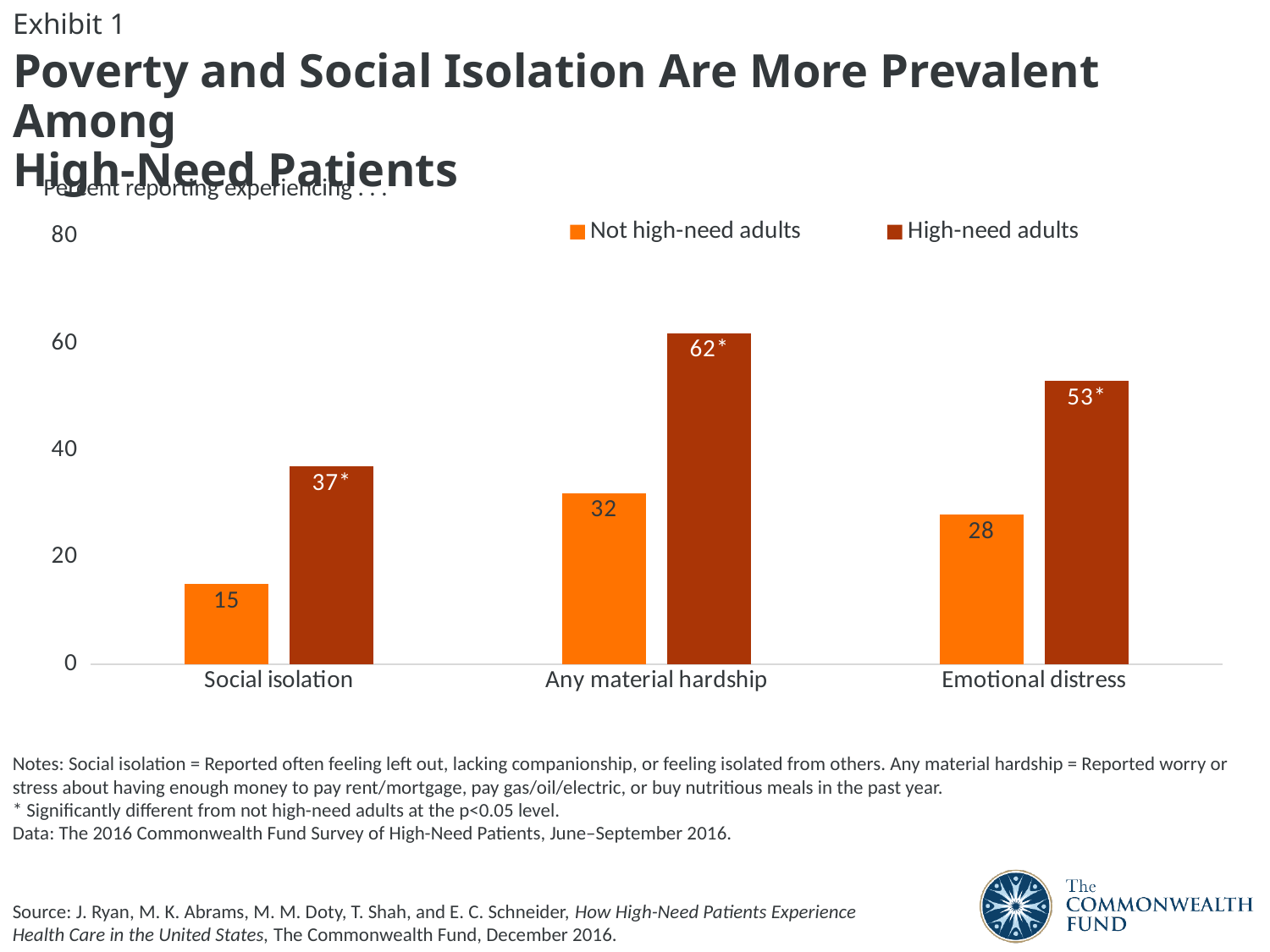
How many series does the legend list? 2 What is the difference between high-need and not high-need adults for social isolation? 22 Is the value for high-need adults for emotional distress greater or less than 40? greater How many categories are shown on the x axis? 3 Which category has the highest value for high-need adults? Any material hardship What percent of not high-need adults reported social isolation? 15 What percent of high-need adults reported any material hardship? 62 What is the difference between high-need and not high-need adults for any material hardship? 30 What is the value for high-need adults for emotional distress? 53 Which category has the lowest value for not high-need adults? Social isolation What kind of chart is shown on the slide? Bar chart Which is larger: the value for not high-need adults for emotional distress or for any material hardship? Any material hardship